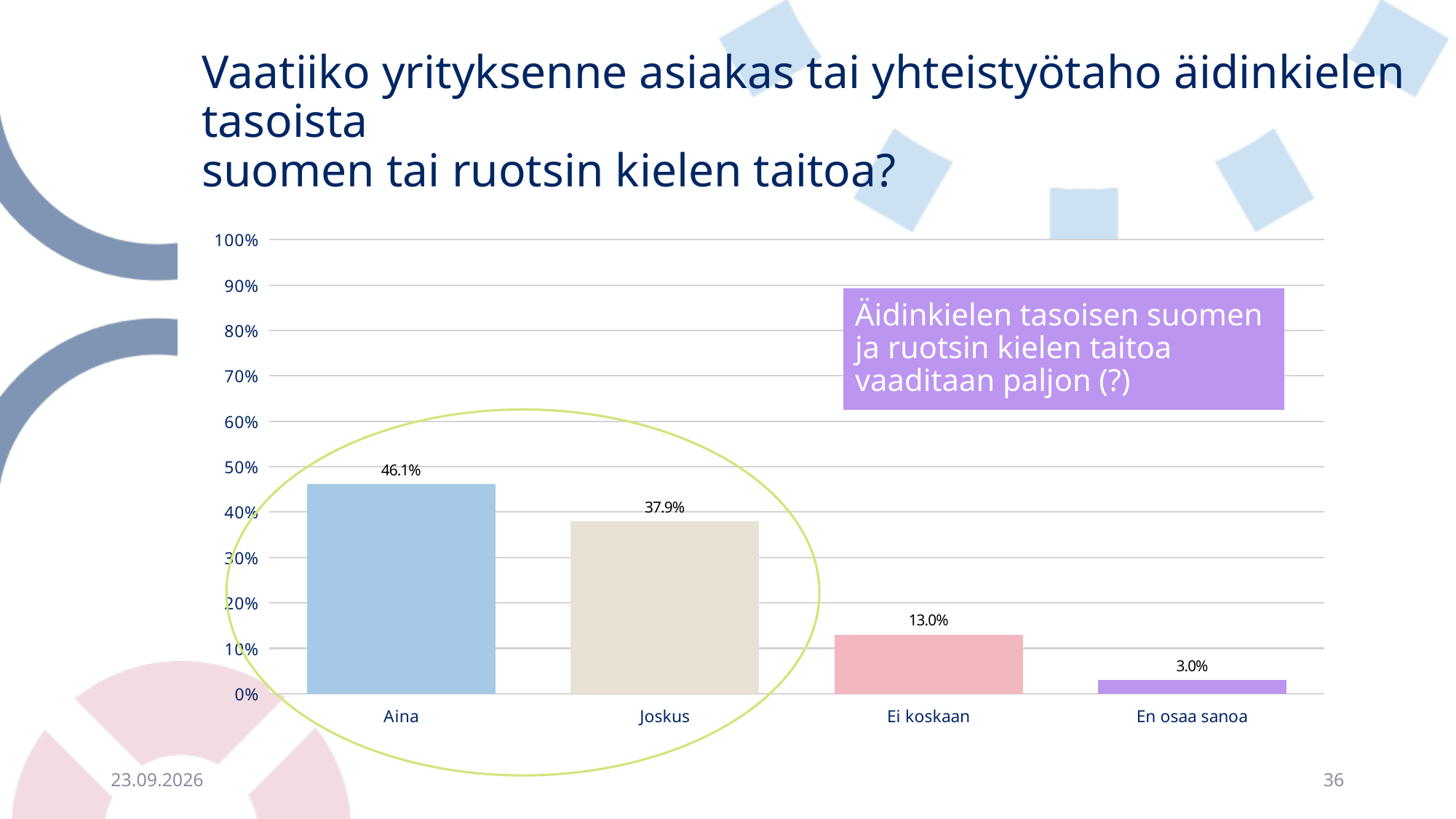
Do the values rise or fall from left to right along the x axis? fall What is the value for Joskus? 37.9% What is the value for Aina? 46.1% What is the difference between the values for Aina and Joskus? 8.2% Which category has the highest value? Aina Is the value for Ei koskaan greater or less than 20%? less What is the value for En osaa sanoa? 3.0% Which category has the lowest value? En osaa sanoa Which is larger, the value for Joskus or the value for Ei koskaan? Joskus What kind of chart is shown on the slide? bar chart What is the value for Ei koskaan? 13.0% How many categories are shown on the x axis? 4